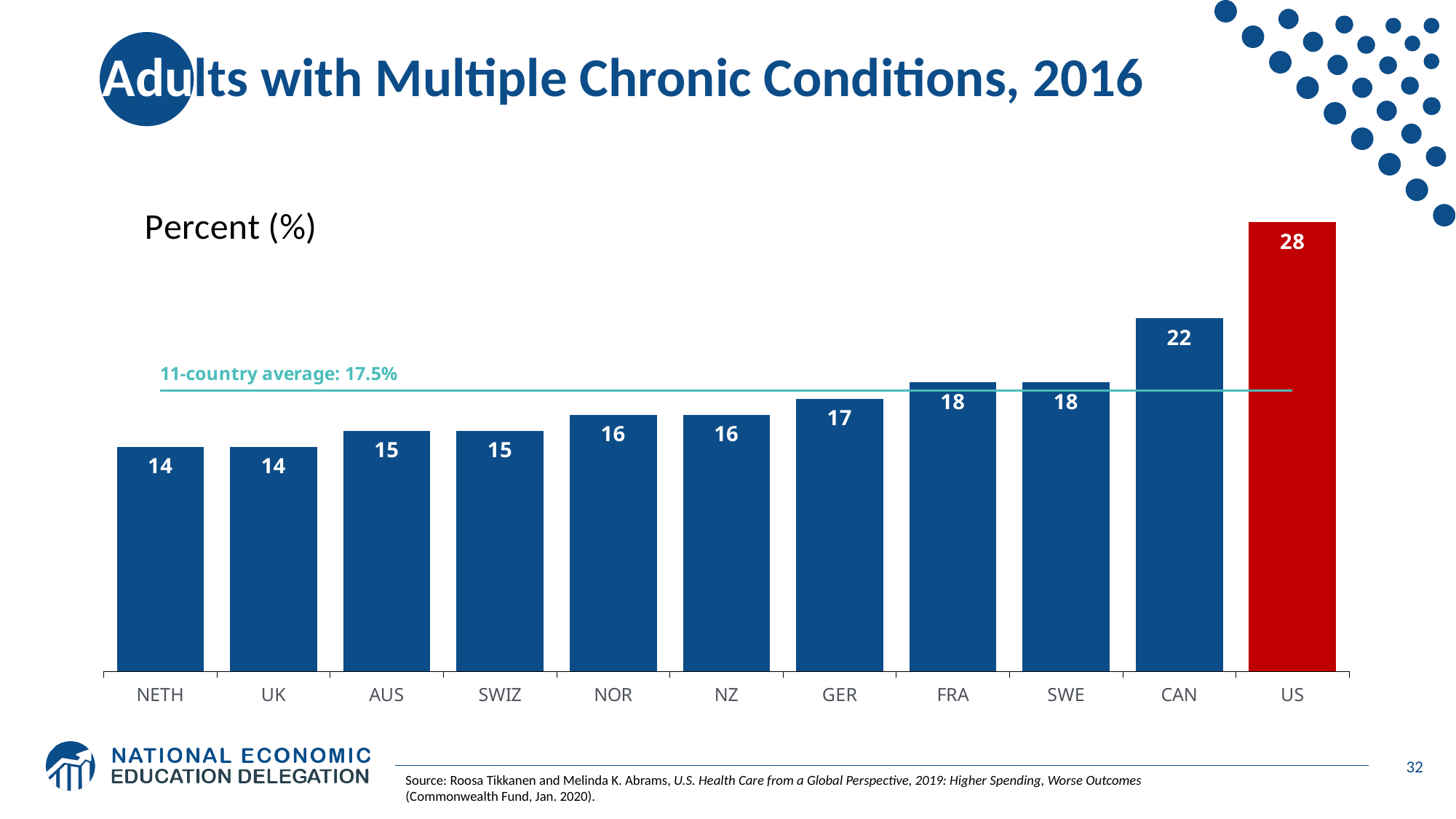
How many countries are shown on the chart? 11 What kind of chart is shown on the slide? Bar chart Which country has the highest value? US Which bar is coloured red? US Do the values rise or fall from NETH to US along the x axis? Rise What is the difference between the values for the US and CAN? 6 Which is larger, the value for NOR or the value for FRA? FRA What is the value for CAN? 22 What is the difference between the values for SWE and NETH? 4 What is the value for the US? 28 What is the 11-country average shown on the chart? 17.5% What is the value for GER? 17